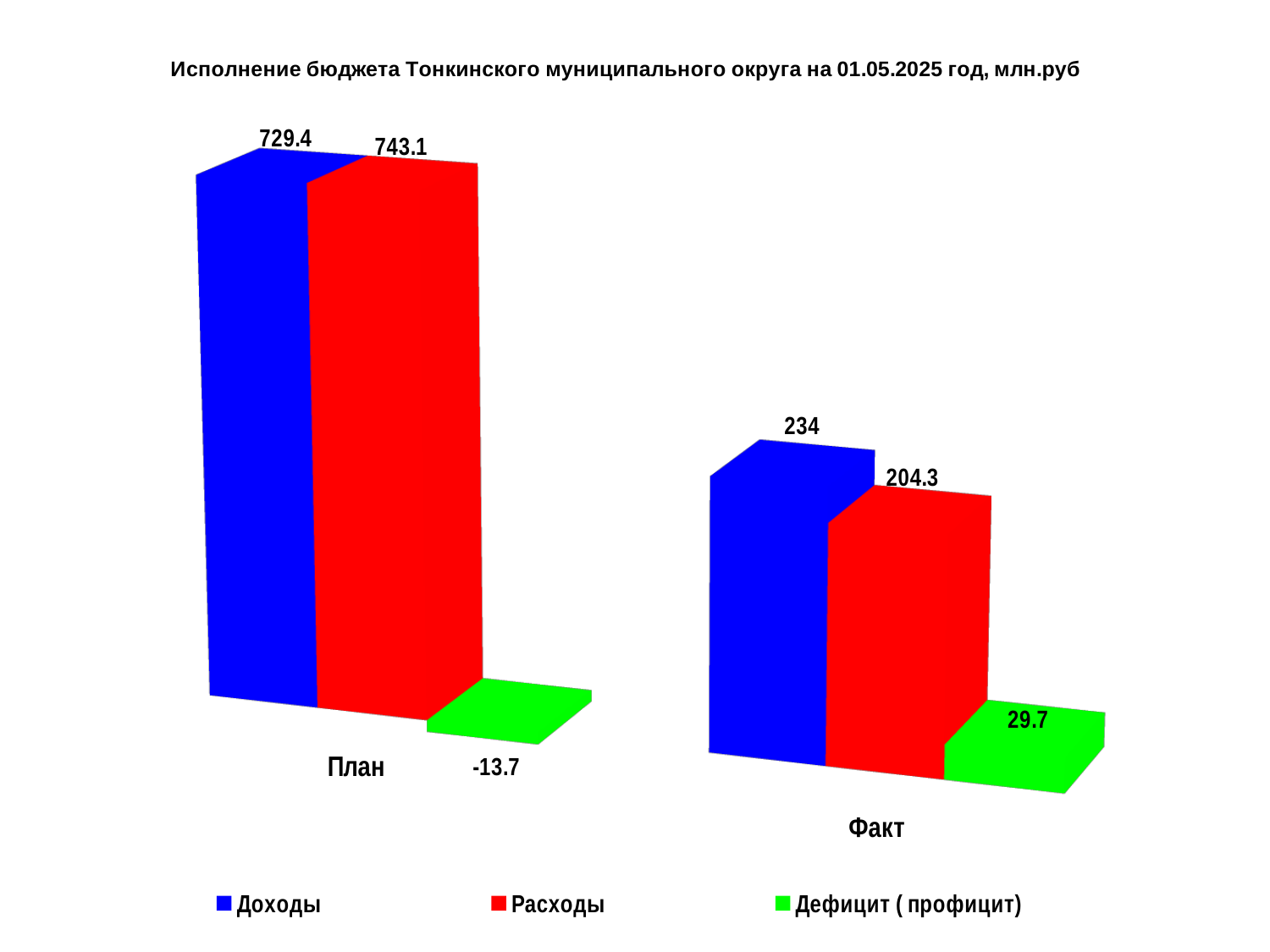
Which category has the lowest value for Дефицит ( профицит)? План What kind of chart is shown on the slide? Bar chart What is the difference between Доходы and Расходы for Факт? 29.7 What is the difference between Расходы and Доходы for План? 13.7 Which category has the highest value for Расходы? План How many series does the legend list? 3 What is the value of Расходы for Факт? 204.3 What is the value of Дефицит ( профицит) for План? -13.7 Which is larger for Факт: Доходы or Расходы? Доходы How many categories are shown on the x axis? 2 What is the value of Доходы for План? 729.4 What is the value of Доходы for Факт? 234